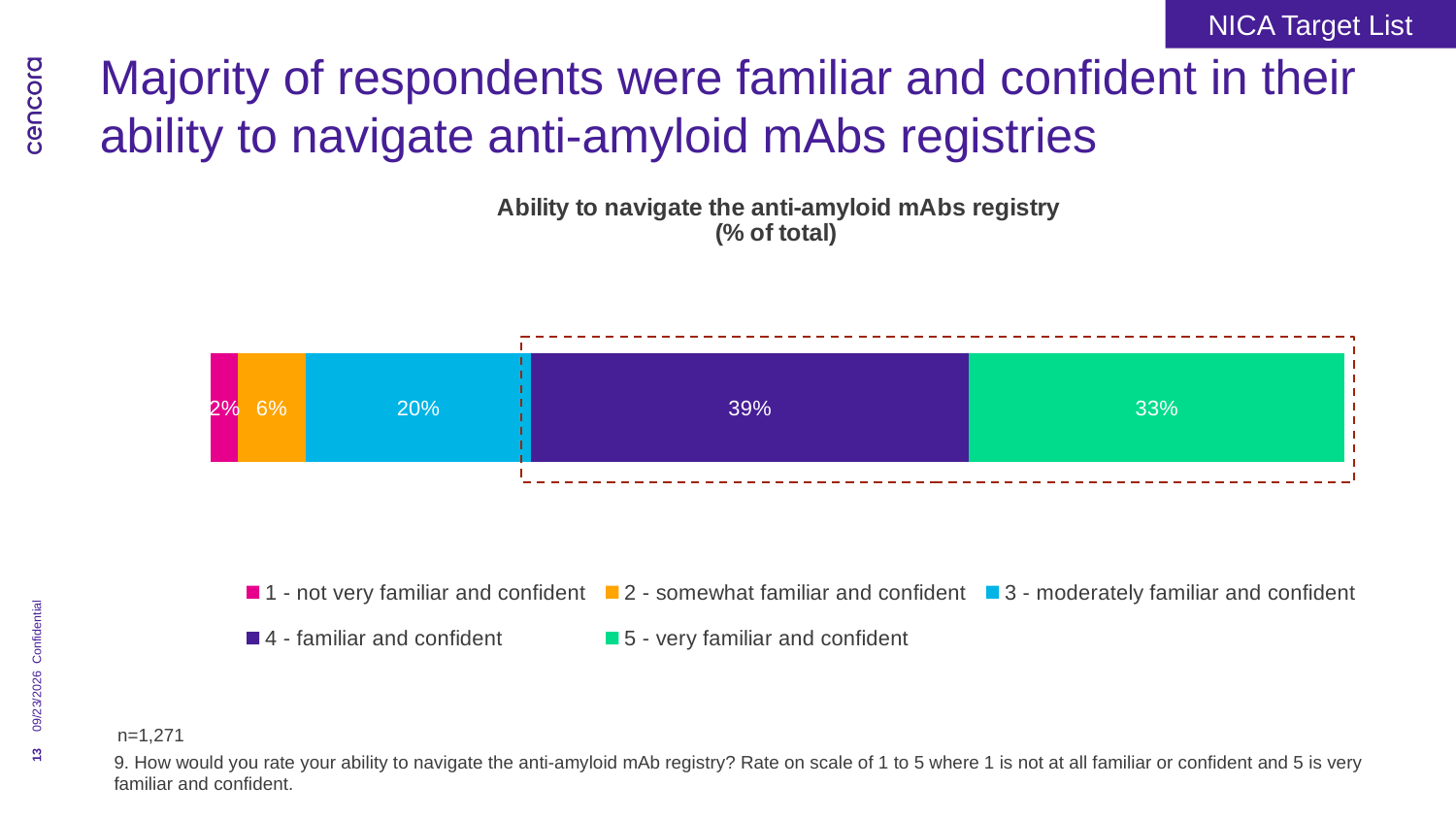
Which rating category has the largest share of respondents? 4 - familiar and confident How many series does the legend list? 5 What is the title of the chart? Ability to navigate the anti-amyloid mAbs registry (% of total) Which rating category has the smallest share of respondents? 1 - not very familiar and confident What percentage of respondents rated themselves '4 - familiar and confident'? 39% Which segment is larger: '2 - somewhat familiar and confident' or '3 - moderately familiar and confident'? 3 - moderately familiar and confident What is the difference in percentage points between the '4 - familiar and confident' and '5 - very familiar and confident' segments? 6 percentage points What is the combined percentage of the two segments enclosed by the dashed outline (ratings 4 and 5)? 72% What type of chart is shown on the slide? Stacked bar chart What percentage of respondents rated themselves '1 - not very familiar and confident'? 2% What percentage of respondents rated themselves '5 - very familiar and confident'? 33% What percentage of respondents rated themselves '3 - moderately familiar and confident'? 20%